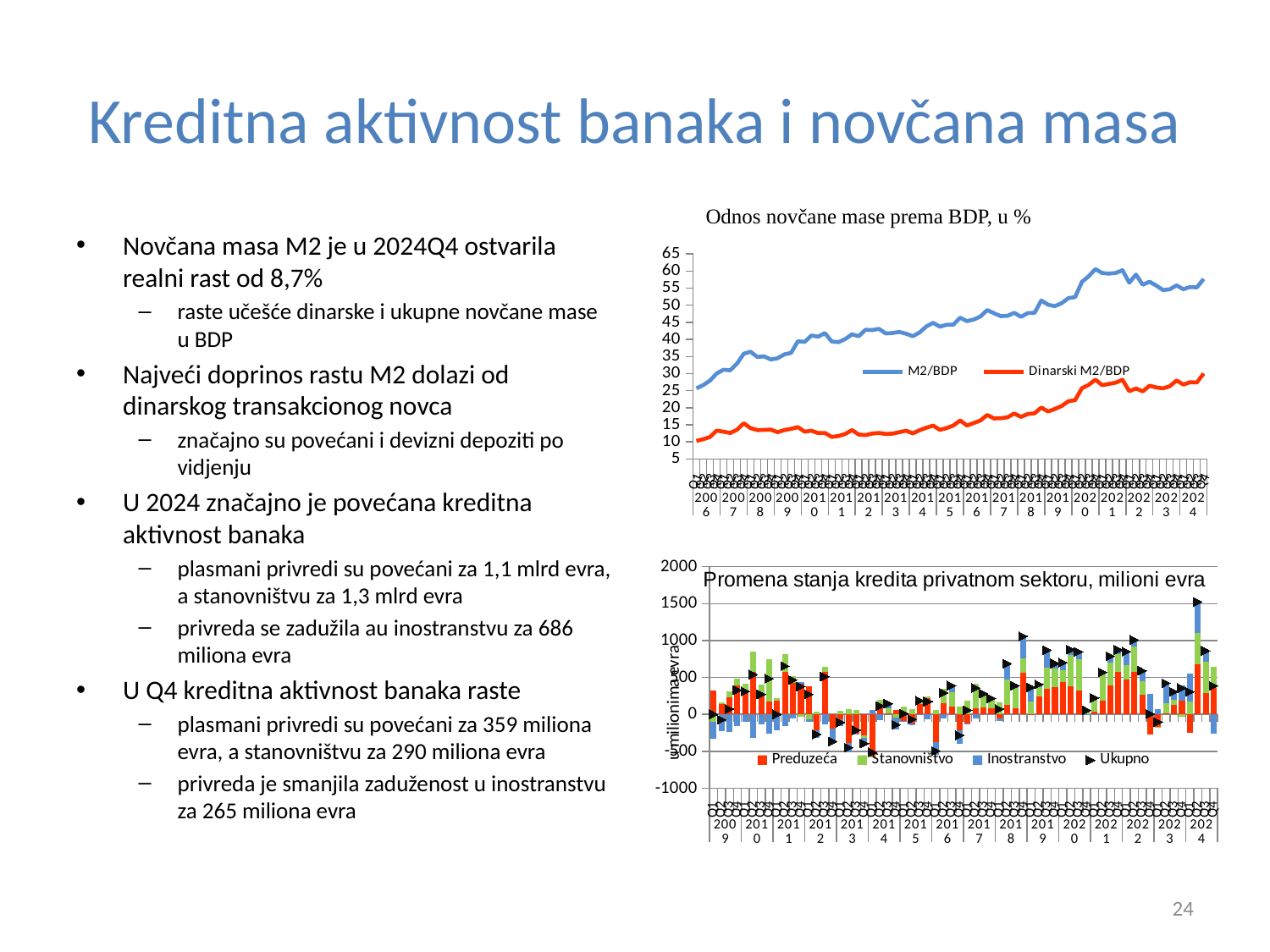
In the top chart "Odnos novčane mase prema BDP, u %", does the M2/BDP series rise or fall overall from 2006 to 2024? rise In the bottom chart "Promena stanja kredita privatnom sektoru, milioni evra", in which year does the Ukupno marker reach its highest point? 2024 In the top chart "Odnos novčane mase prema BDP, u %", which series is plotted higher throughout, M2/BDP or Dinarski M2/BDP? M2/BDP What is the title of the bottom chart on the slide? Promena stanja kredita privatnom sektoru, milioni evra In the top chart "Odnos novčane mase prema BDP, u %", is the M2/BDP value at the end of 2024 greater or less than 50? greater What kind of chart is the bottom chart "Promena stanja kredita privatnom sektoru, milioni evra"? bar chart In the top chart "Odnos novčane mase prema BDP, u %", is the M2/BDP value at the start of 2006 greater or less than 30? less How many series does the legend of the bottom chart "Promena stanja kredita privatnom sektoru, milioni evra" list? 4 How many series does the legend of the top chart "Odnos novčane mase prema BDP, u %" list? 2 In the top chart "Odnos novčane mase prema BDP, u %", is the Dinarski M2/BDP value at the end of 2024 greater or less than 35? less What kind of chart is the top chart titled "Odnos novčane mase prema BDP, u %"? line chart